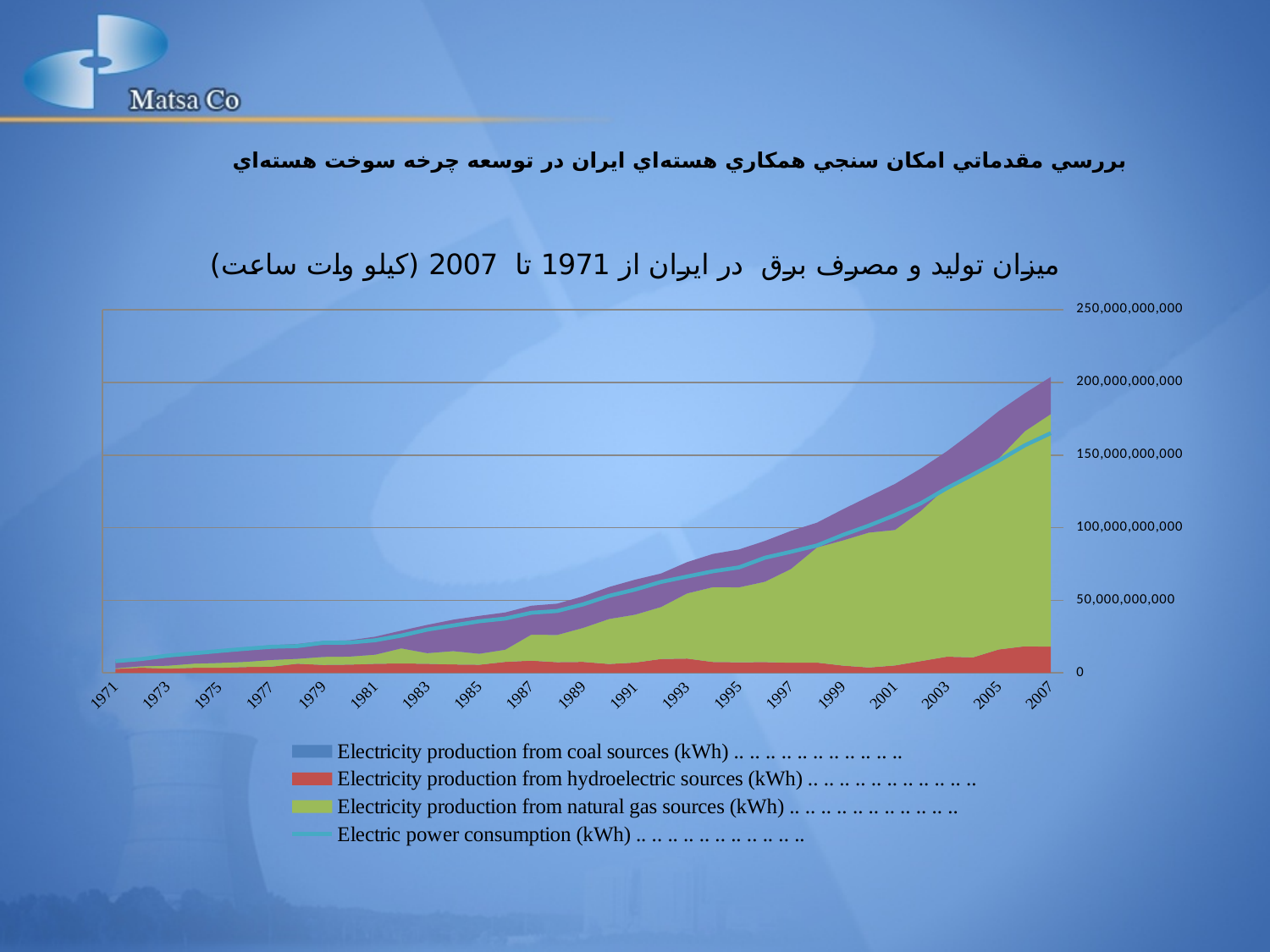
Which electricity production source contributes the largest area in 2007? Electricity production from natural gas sources (kWh) Which electricity production source contributes the smallest area across the chart? Electricity production from coal sources (kWh) Does electric power consumption rise or fall from 1971 to 2007? rise What kind of chart is shown on the slide? stacked area chart with a line Is the electric power consumption value for 2007 greater or less than 150,000,000,000? greater Is the electricity production from hydroelectric sources in 2007 greater or less than 50,000,000,000? less In which year is electric power consumption highest? 2007 Is the electric power consumption value for 1985 greater or less than 50,000,000,000? less Which colour represents electricity production from natural gas sources in the legend? green How many series does the legend list? 4 What is the highest value shown on the vertical axis? 250,000,000,000